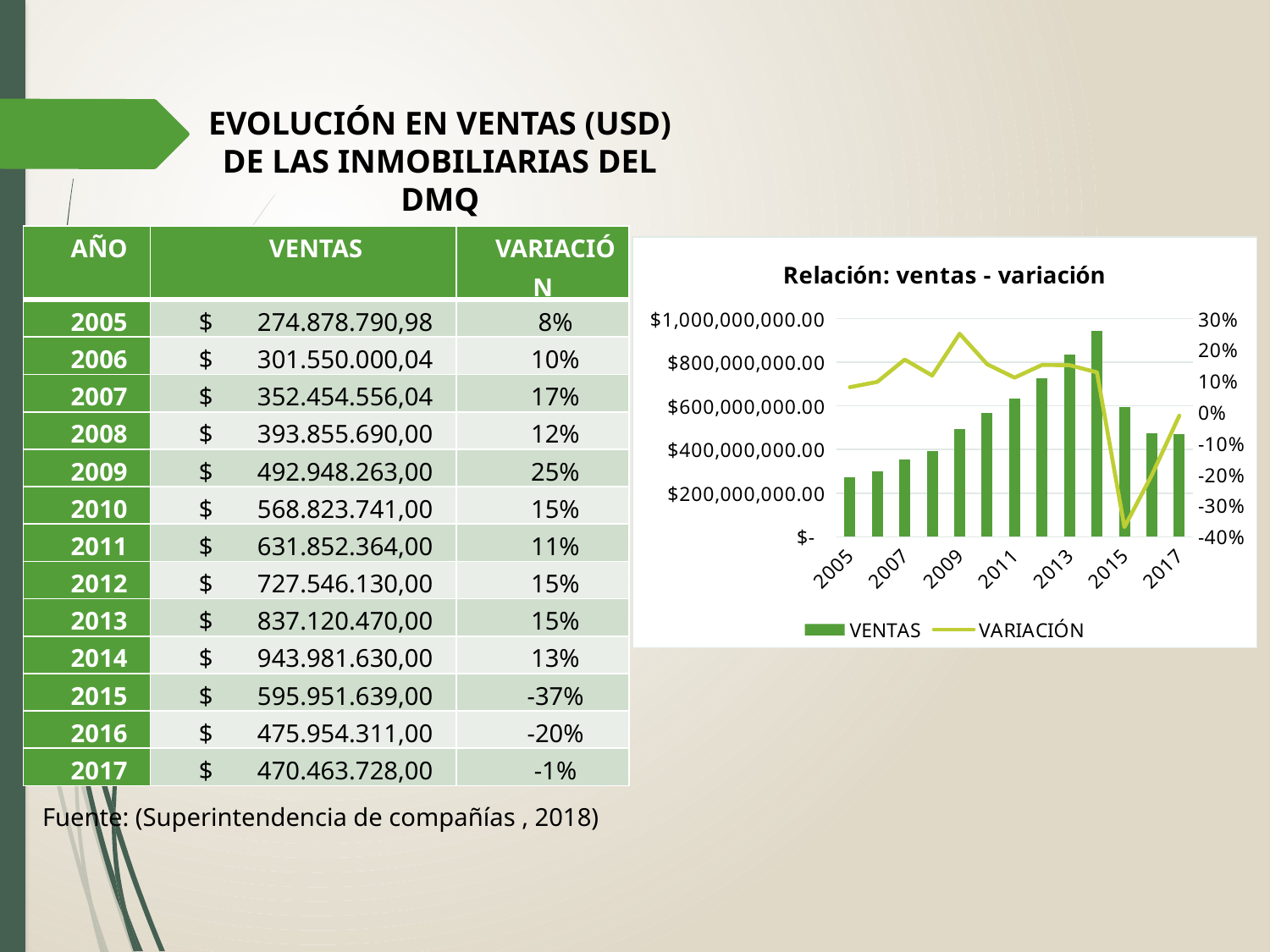
Is the VENTAS value for 2014 greater or less than $800,000,000.00? greater Which year has the larger VENTAS bar, 2010 or 2016? 2010 Which series in the chart is drawn as a line rather than bars? VARIACIÓN Is the VARIACIÓN value for 2015 greater or less than -30%? less In which year does the VARIACIÓN line reach its lowest point? 2015 What is the title of the chart on the right of the slide? Relación: ventas - variación In which year is the VENTAS bar the highest? 2014 How many years are plotted along the x axis of the chart? 13 How many series does the chart legend list? 2 In which year is the VENTAS bar the lowest? 2005 What kind of chart is shown on the slide? Combined bar and line chart Is the VENTAS value for 2005 greater or less than $400,000,000.00? less